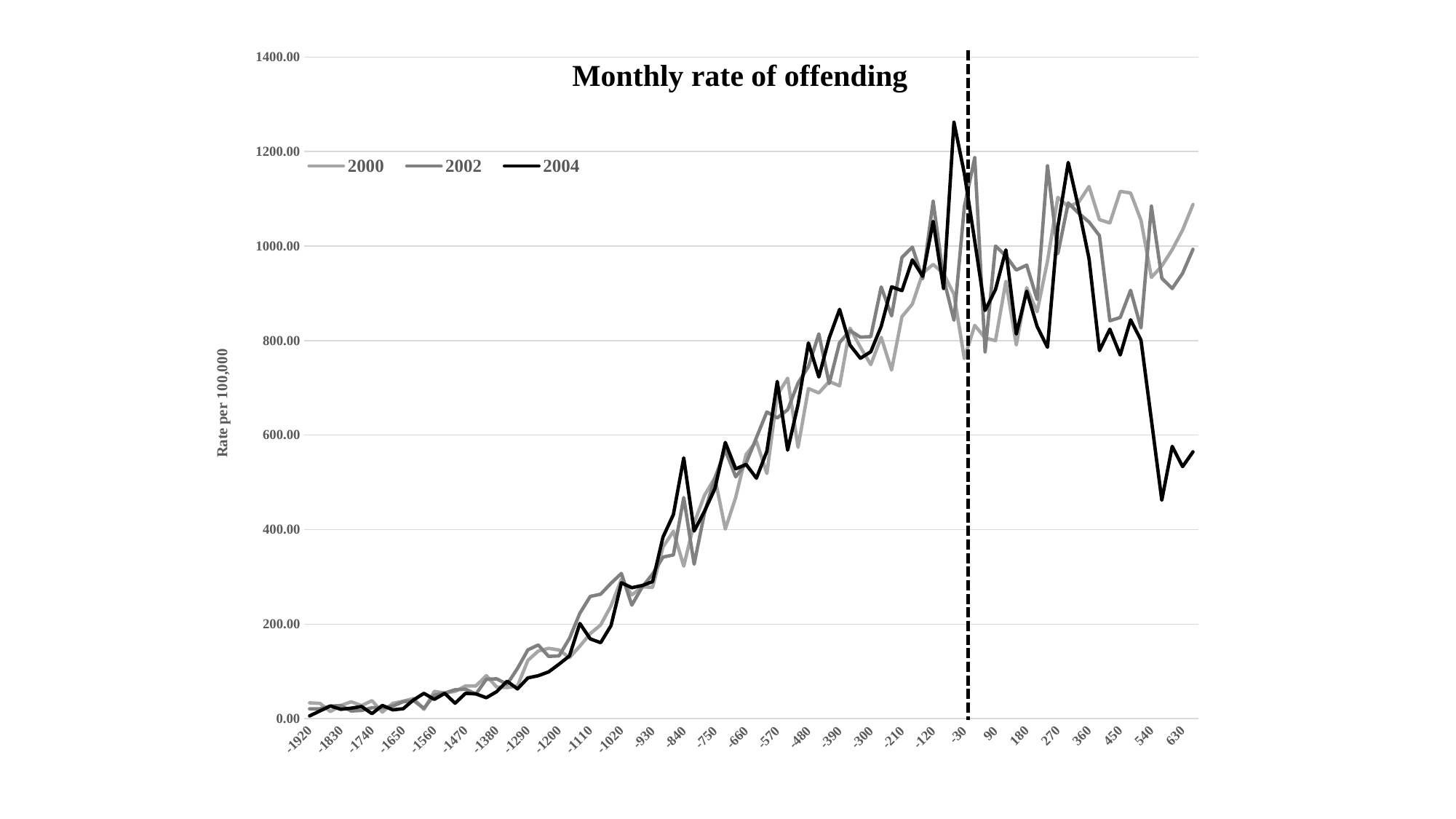
Is the value for the 2000 series at -30 greater or less than 1000? less Is the highest value of the 2004 series greater or less than 1200? greater What kind of chart is shown on the slide? Line chart What is the title of the chart? Monthly rate of offending How many series does the legend list? 3 Do the values generally rise or fall along the x axis from -1920 to -30? Rise Is the value for the 2004 series at 630 greater or less than 800? less At 630, which series has the larger value, 2000 or 2004? 2000 What is the label on the vertical axis? Rate per 100,000 At 630, which series has the lowest value? 2004 Which series is plotted with the black line? 2004